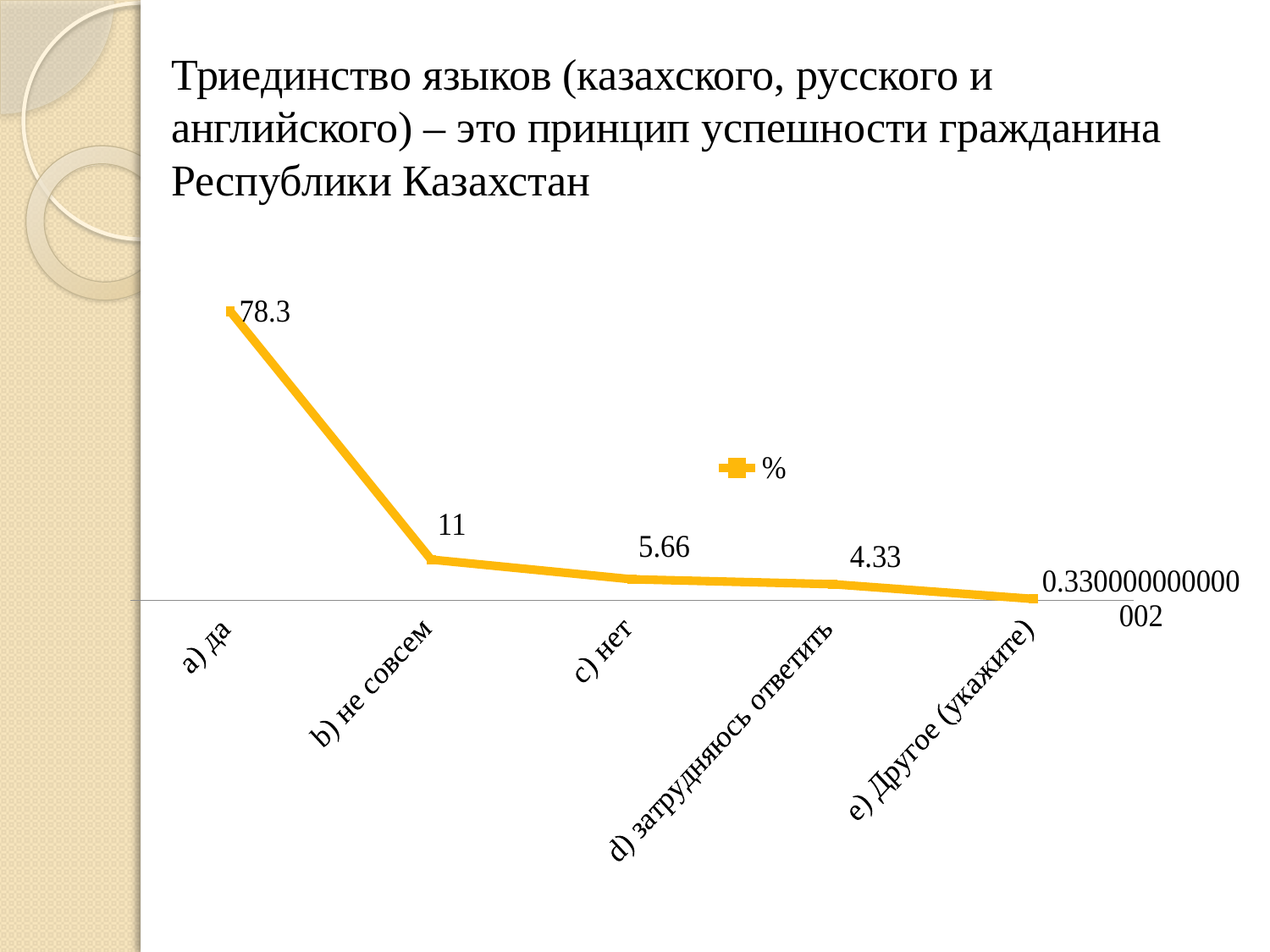
Do the values rise or fall from left to right along the x axis? fall Which category has the highest value? a) да What is the value for "c) нет"? 5.66 What type of chart is shown on the slide? line chart How many categories are plotted on the x axis? 5 Which category has the lowest value? e) Другое (укажите) What is the difference between the values for "b) не совсем" and "c) нет"? 5.34 What is the value for "b) не совсем"? 11 What is the value for "a) да"? 78.3 Which is larger, the value for "c) нет" or the value for "d) затрудняюсь ответить"? c) нет What is the value for "d) затрудняюсь ответить"? 4.33 What is the difference between the values for "a) да" and "b) не совсем"? 67.3